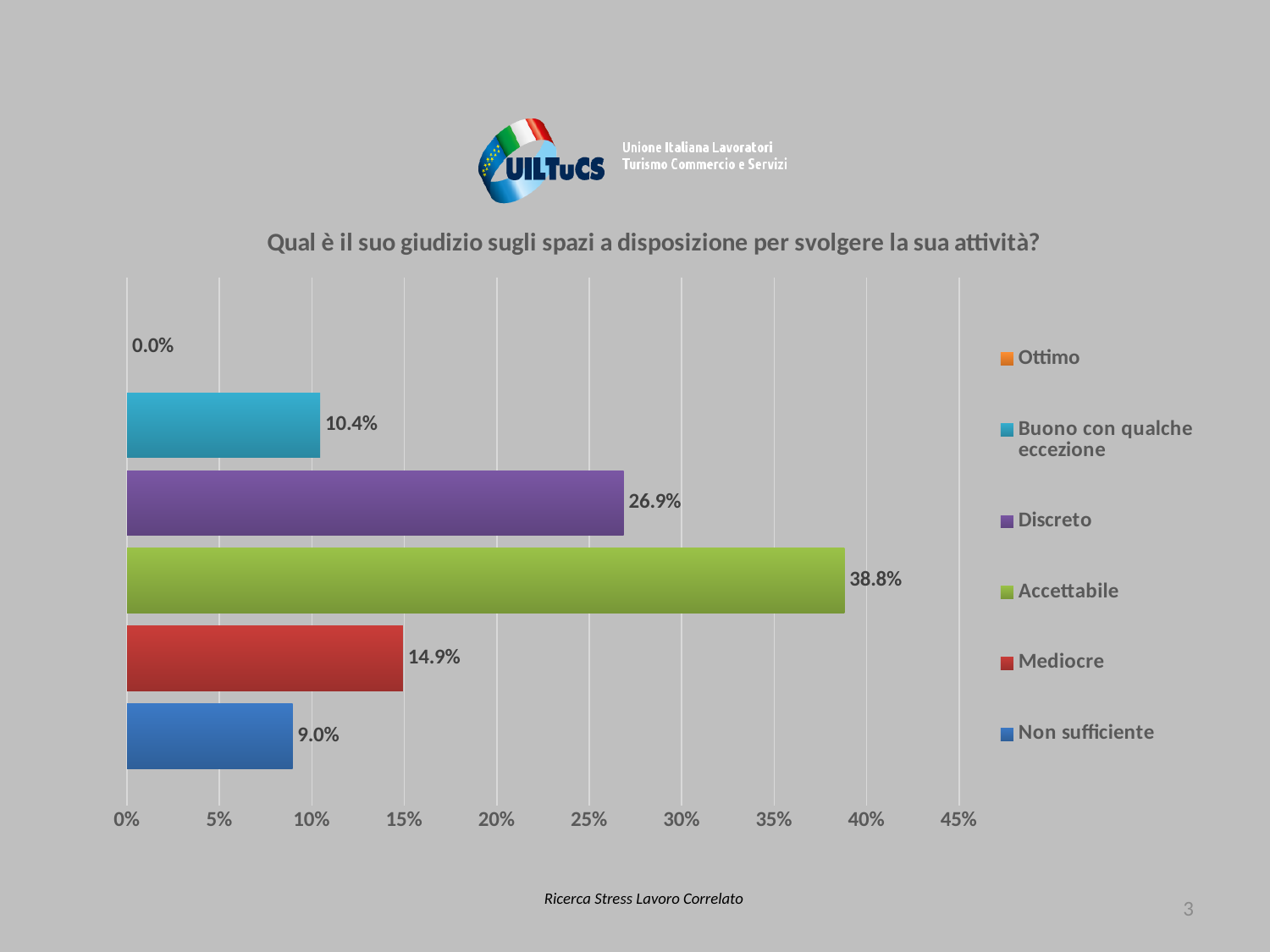
What value is shown for Accettabile? 38.8% What value is shown for Buono con qualche eccezione? 10.4% What kind of chart is shown on the slide? Bar chart Which category has the highest value? Accettabile How many categories does the legend list? 6 What value is shown for Non sufficiente? 9.0% What value is shown for Discreto? 26.9% What is the difference between the values for Accettabile and Discreto? 11.9% Which is larger, the value for Mediocre or the value for Non sufficiente? Mediocre What is the title of the chart? Qual è il suo giudizio sugli spazi a disposizione per svolgere la sua attività? Which category has the lowest value? Ottimo What value is shown for Ottimo? 0.0%